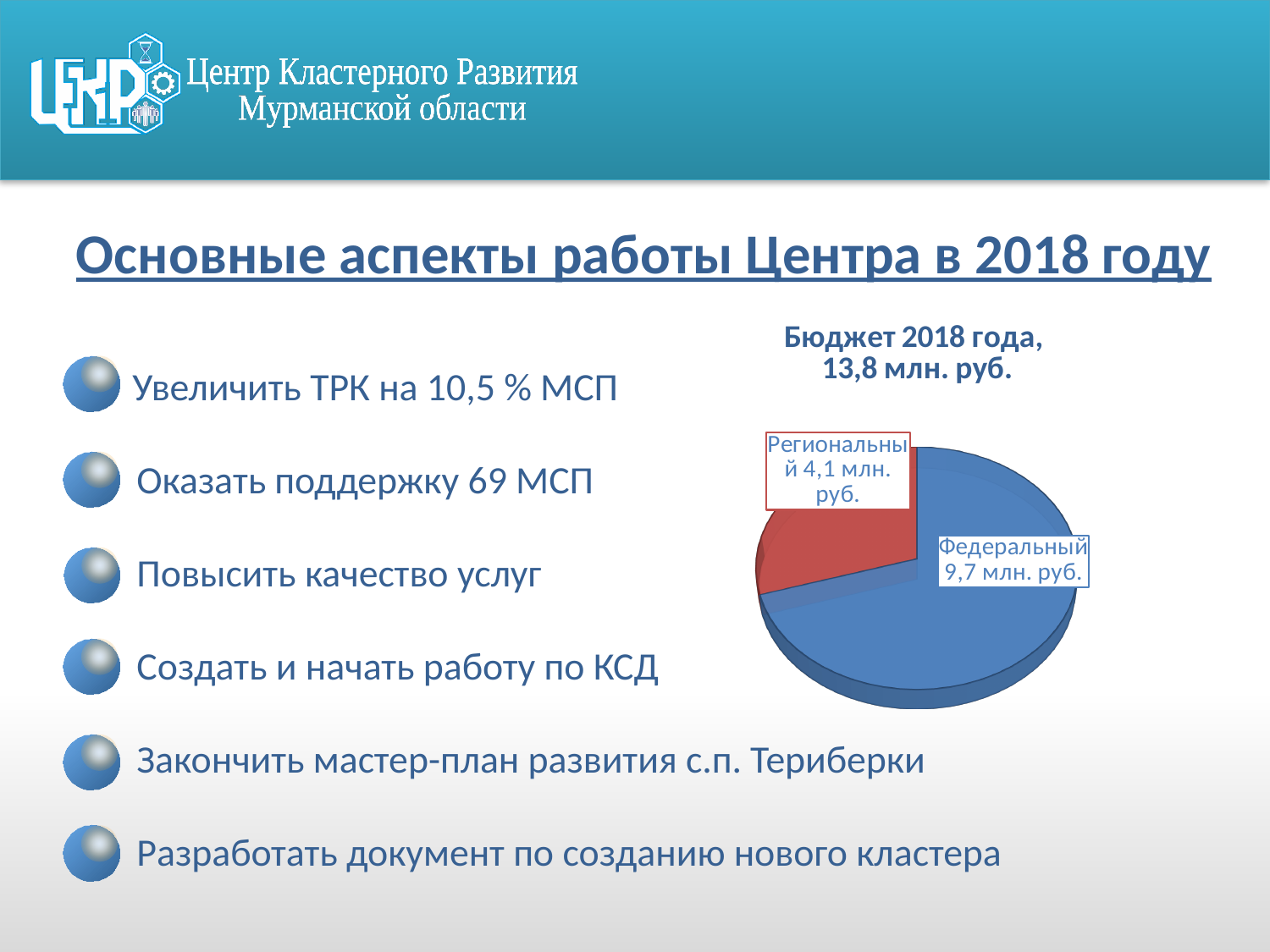
What is the value of the Федеральный slice? 9,7 млн. руб. What colour is the Региональный slice? red Which slice of the pie is the largest? Федеральный How many slices does the pie chart have? 2 What is the title of the chart? Бюджет 2018 года, 13,8 млн. руб. Which is larger, the Федеральный or the Региональный budget? Федеральный What is the value of the Региональный slice? 4,1 млн. руб. What is the total of the two slices in the pie chart? 13,8 млн. руб. What type of chart is shown on the slide? pie chart What is the difference between the Федеральный and Региональный values? 5,6 млн. руб. Which slice of the pie is the smallest? Региональный